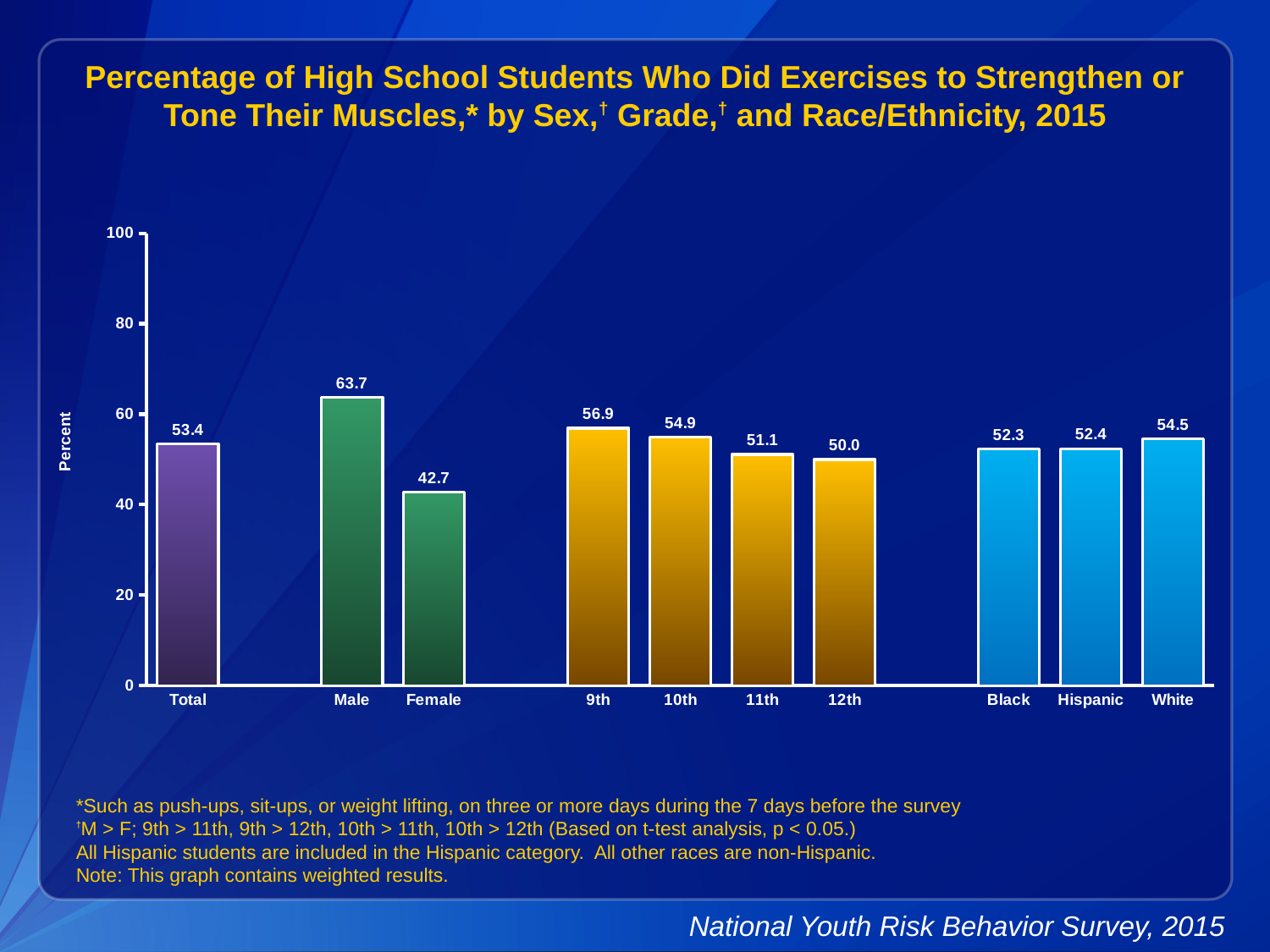
Which is larger, the value for 9th grade or 12th grade? 9th What is the value for Female? 42.7 What kind of chart is shown on the slide? bar chart Which category has the highest value? Male What is the value for 11th grade? 51.1 Do the values rise or fall from 9th grade to 12th grade? fall What is the label of the y axis? Percent Which category has the lowest value? Female What is the difference between the values for Male and Female? 21.0 How many bars are shown in the chart? 10 What is the value for Total? 53.4 Is the value for Male greater or less than 60? greater